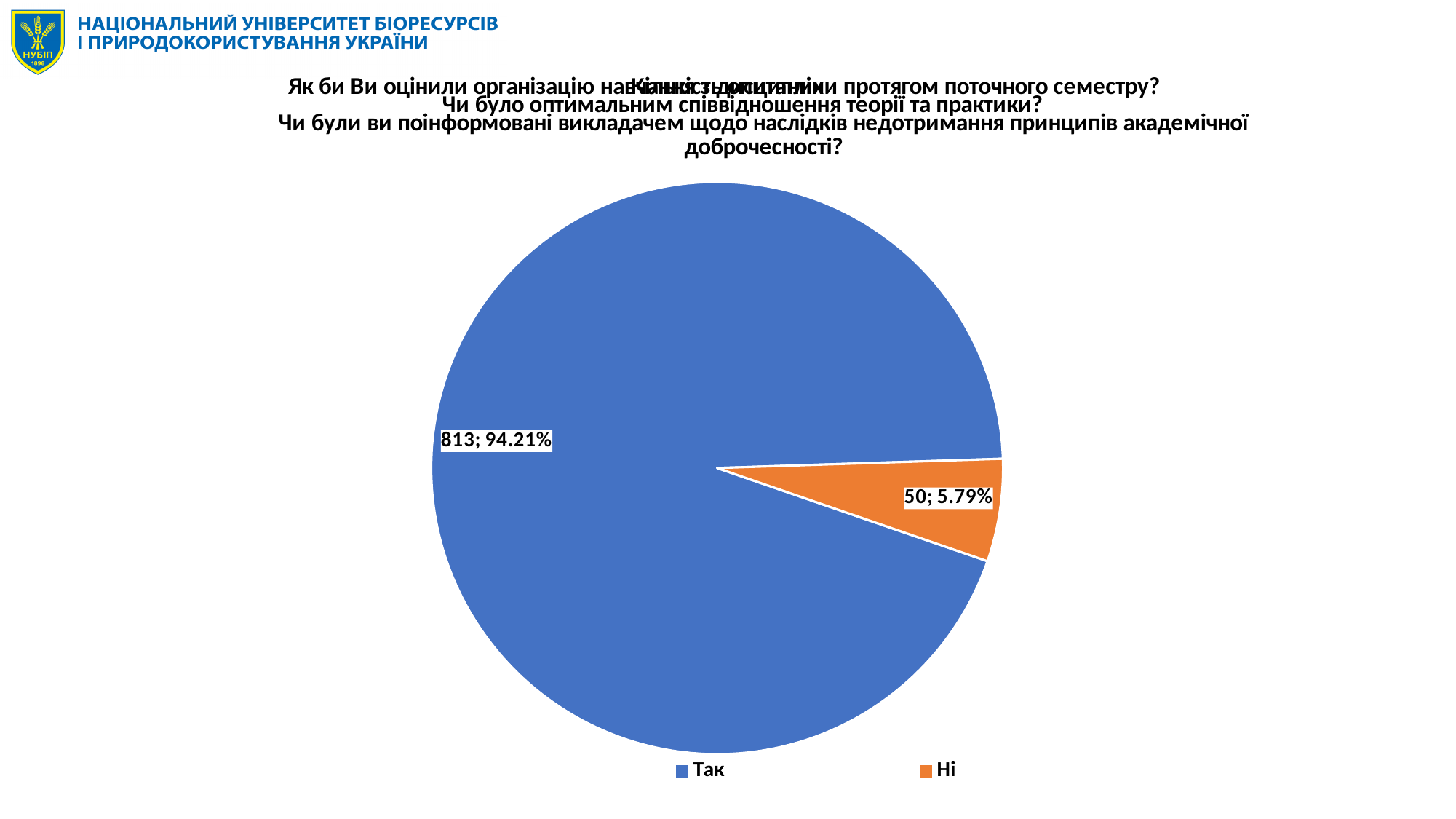
Which slice is the smallest? Ні What percentage share does the "Так" slice have? 94.21% Which slice is the largest? Так How many entries does the legend list? 2 What percentage share does the "Ні" slice have? 5.79% What is the count shown for the "Ні" slice? 50 What colour is the "Ні" slice? orange What is the count shown for the "Так" slice? 813 Which is larger, the value for "Так" or the value for "Ні"? Так What is the difference between the counts for "Так" and "Ні"? 763 What kind of chart is shown on the slide? pie chart How many slices does the pie chart have? 2